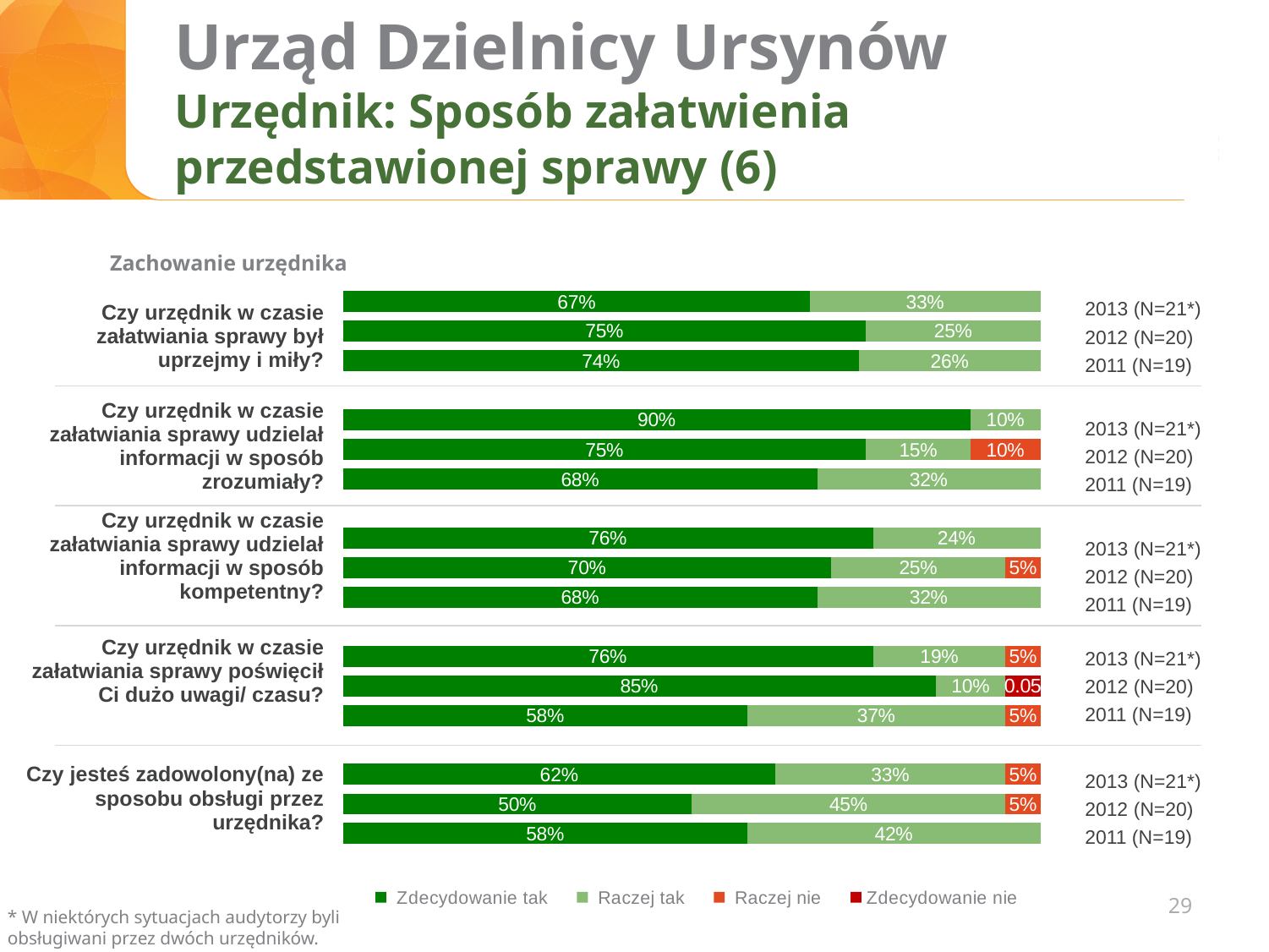
For "Czy jesteś zadowolony(na) ze sposobu obsługi przez urzędnika?", which year has the lowest "Zdecydowanie tak" share? 2012 (N=20) What percentage answered "Raczej tak" in 2011 to "Czy urzędnik w czasie załatwiania sprawy udzielał informacji w sposób zrozumiały?"? 32% How many series does the legend list? 4 What percentage answered "Zdecydowanie tak" in 2013 to "Czy urzędnik w czasie załatwiania sprawy był uprzejmy i miły?"? 67% For "Czy jesteś zadowolony(na) ze sposobu obsługi przez urzędnika?", which year has the larger "Raczej tak" share, 2012 or 2013? 2012 (N=20) For "Czy urzędnik w czasie załatwiania sprawy poświęcił Ci dużo uwagi/ czasu?", what is the difference in "Zdecydowanie tak" between 2013 and 2011? 18 percentage points What percentage answered "Raczej nie" in 2012 to "Czy urzędnik w czasie załatwiania sprawy udzielał informacji w sposób zrozumiały?"? 10% What kind of chart is shown on the slide? Stacked bar chart What percentage answered "Raczej tak" in 2011 to "Czy jesteś zadowolony(na) ze sposobu obsługi przez urzędnika?"? 42% What is the total of the 2013 bar for "Czy jesteś zadowolony(na) ze sposobu obsługi przez urzędnika?"? 100% For "Czy urzędnik w czasie załatwiania sprawy udzielał informacji w sposób zrozumiały?", which year has the highest "Zdecydowanie tak" share? 2013 (N=21*) How many years (bars) are shown for each question? 3